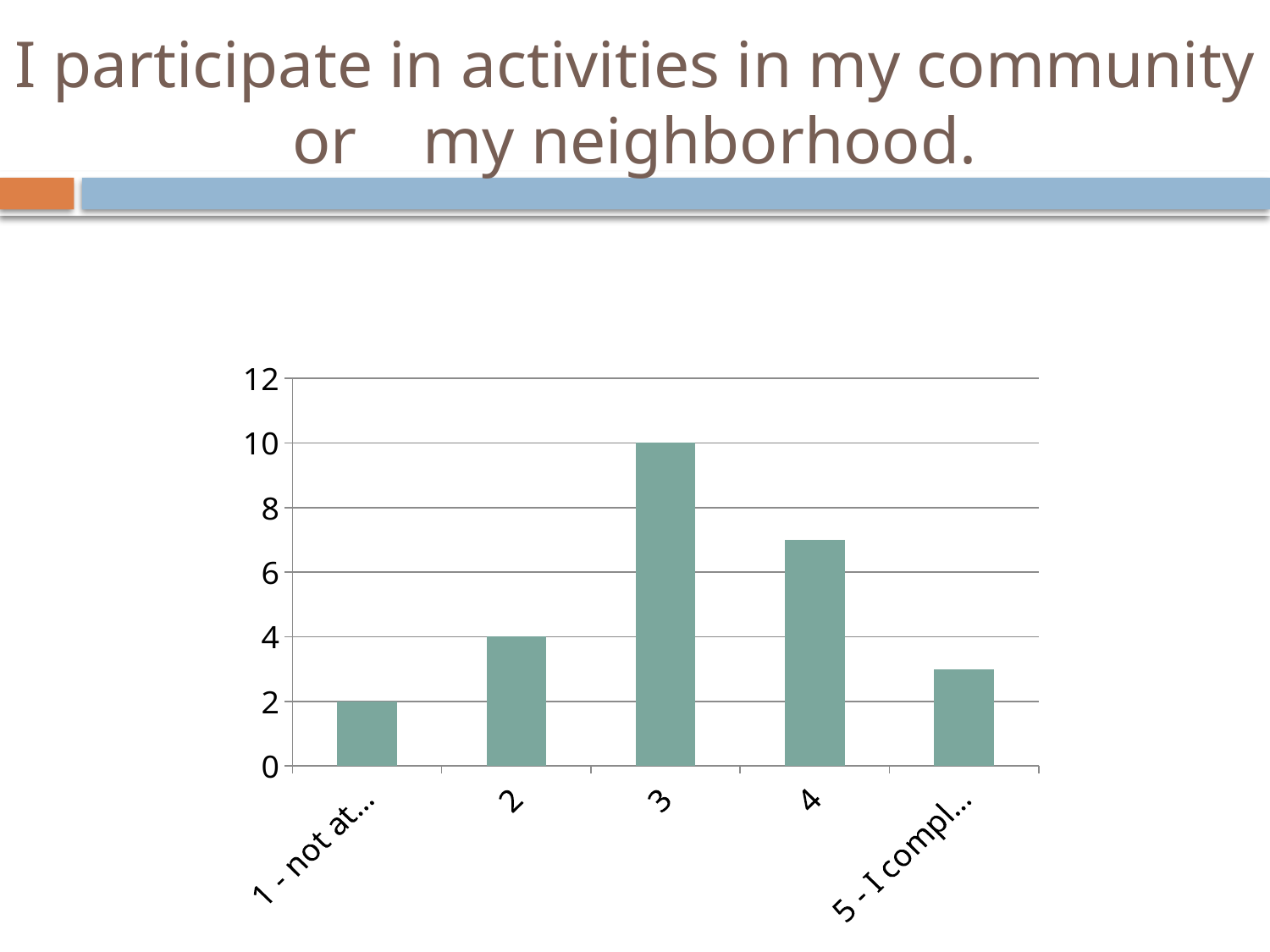
What is the value for the first category, labelled "1 - not at..."? 2 What kind of chart is shown on the slide? bar chart What is the highest value shown on the vertical axis? 12 What is the difference between the value for category 3 and the value for category 2? 6 What is the value for category 2? 4 Which category has the lowest bar? 1 - not at... Which is larger, the value for category 4 or the value for category 2? category 4 Is the value for category 4 greater or less than 6? greater Is the value for the last category, labelled "5 - I compl...", greater or less than 4? less How many categories are shown on the x axis of the chart? 5 What is the value for category 3? 10 Which category has the highest bar? 3